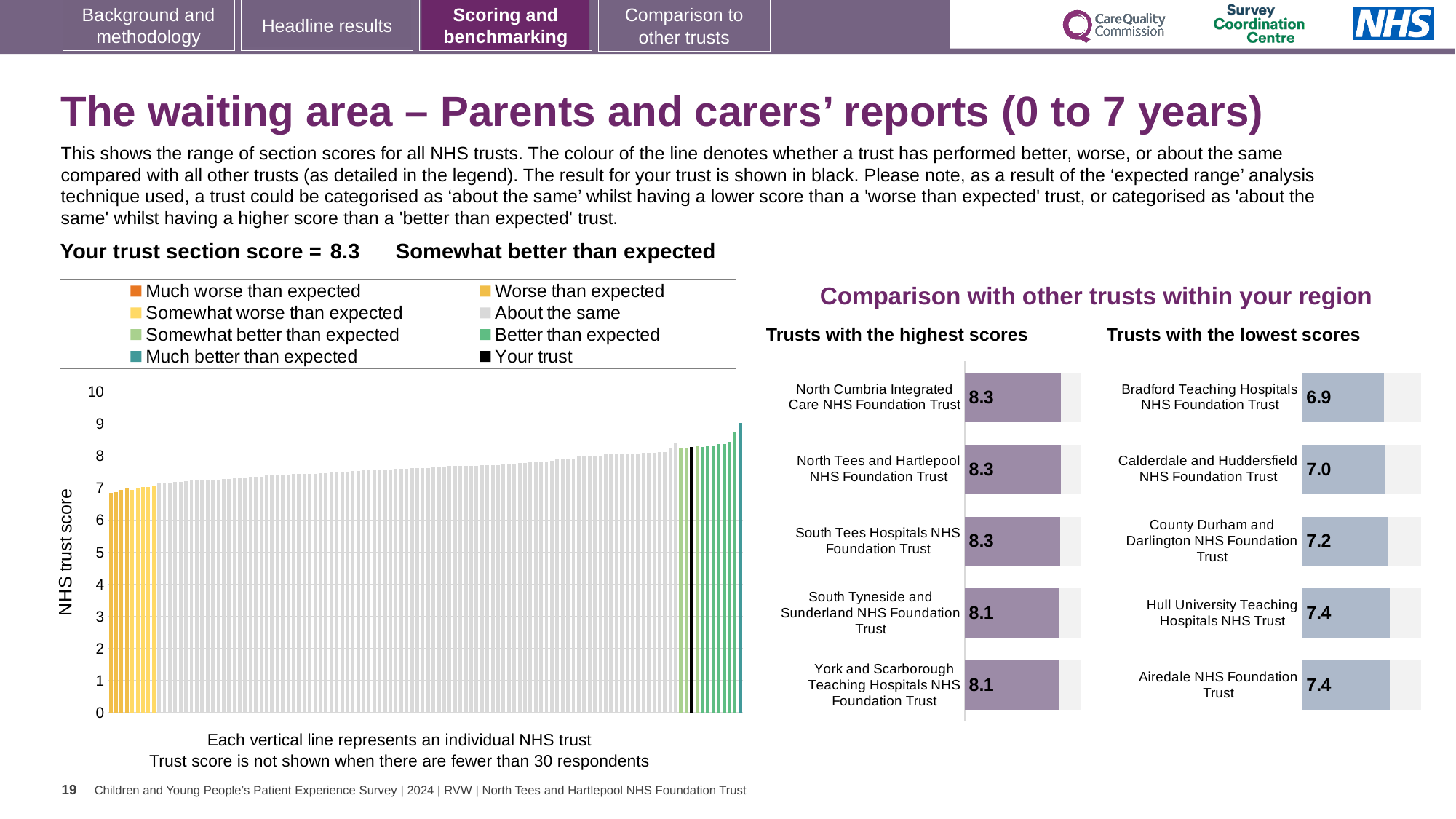
In the 'Trusts with the lowest scores' chart, what is the difference between the scores of Airedale NHS Foundation Trust and Bradford Teaching Hospitals NHS Foundation Trust? 0.5 In the large chart on the left, is the value of the tallest bar greater or less than 8? greater What is the y-axis label of the large chart on the left? NHS trust score In the 'Trusts with the lowest scores' chart, what is the score for Bradford Teaching Hospitals NHS Foundation Trust? 6.9 How many entries does the legend of the large chart on the left list? 8 In the 'Trusts with the lowest scores' chart, which trust has the lowest score? Bradford Teaching Hospitals NHS Foundation Trust In the 'Trusts with the highest scores' chart, what is the score for North Cumbria Integrated Care NHS Foundation Trust? 8.3 What kind of chart is the large chart on the left showing NHS trust scores? Bar chart In the 'Trusts with the lowest scores' chart, what is the score for County Durham and Darlington NHS Foundation Trust? 7.2 In the 'Trusts with the lowest scores' chart, which has the higher score: Calderdale and Huddersfield NHS Foundation Trust or Hull University Teaching Hospitals NHS Trust? Hull University Teaching Hospitals NHS Trust In the 'Trusts with the highest scores' chart, what is the score for South Tyneside and Sunderland NHS Foundation Trust? 8.1 How many trusts are shown in the 'Trusts with the highest scores' chart? 5